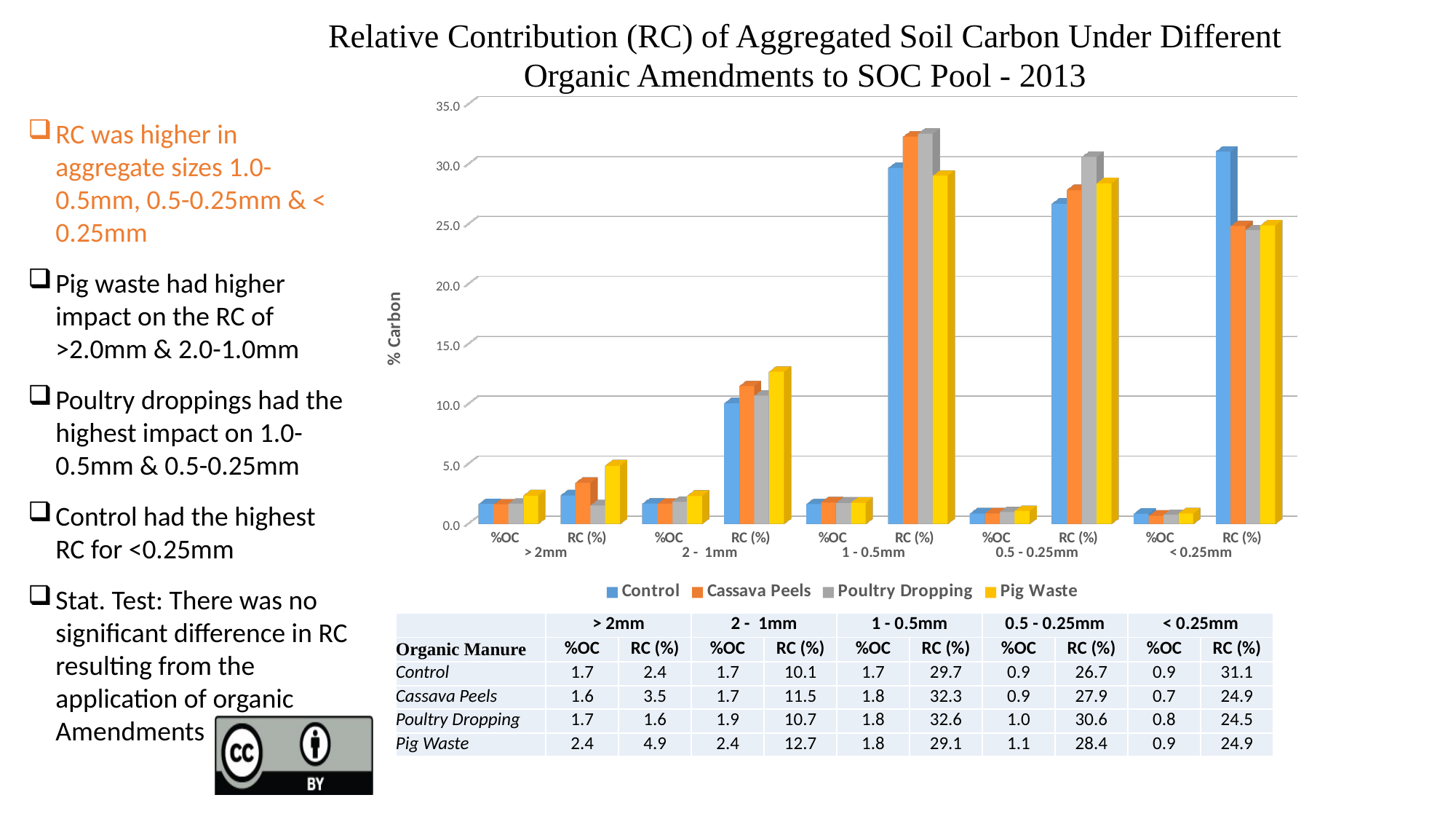
What is the difference between the RC (%) of Control and Cassava Peels in the < 0.25mm aggregate size? 6.2 What kind of chart is shown on the slide? bar chart Which series has the highest RC (%) in the > 2mm aggregate size? Pig Waste How many series does the legend list? 4 What is the RC (%) value for Poultry Dropping in the 0.5 - 0.25mm aggregate size? 30.6 What is the title of the vertical axis of the chart? % Carbon What is the RC (%) value for Pig Waste in the > 2mm aggregate size? 4.9 Is the RC (%) value for Control in the 0.5 - 0.25mm aggregate size greater or less than 25.0? greater Which series has the highest RC (%) in the < 0.25mm aggregate size? Control Which is larger in the 2 - 1mm aggregate size: the RC (%) for Pig Waste or for Control? Pig Waste Which series has the lowest RC (%) in the > 2mm aggregate size? Poultry Dropping What is the RC (%) value for Control in the < 0.25mm aggregate size? 31.1